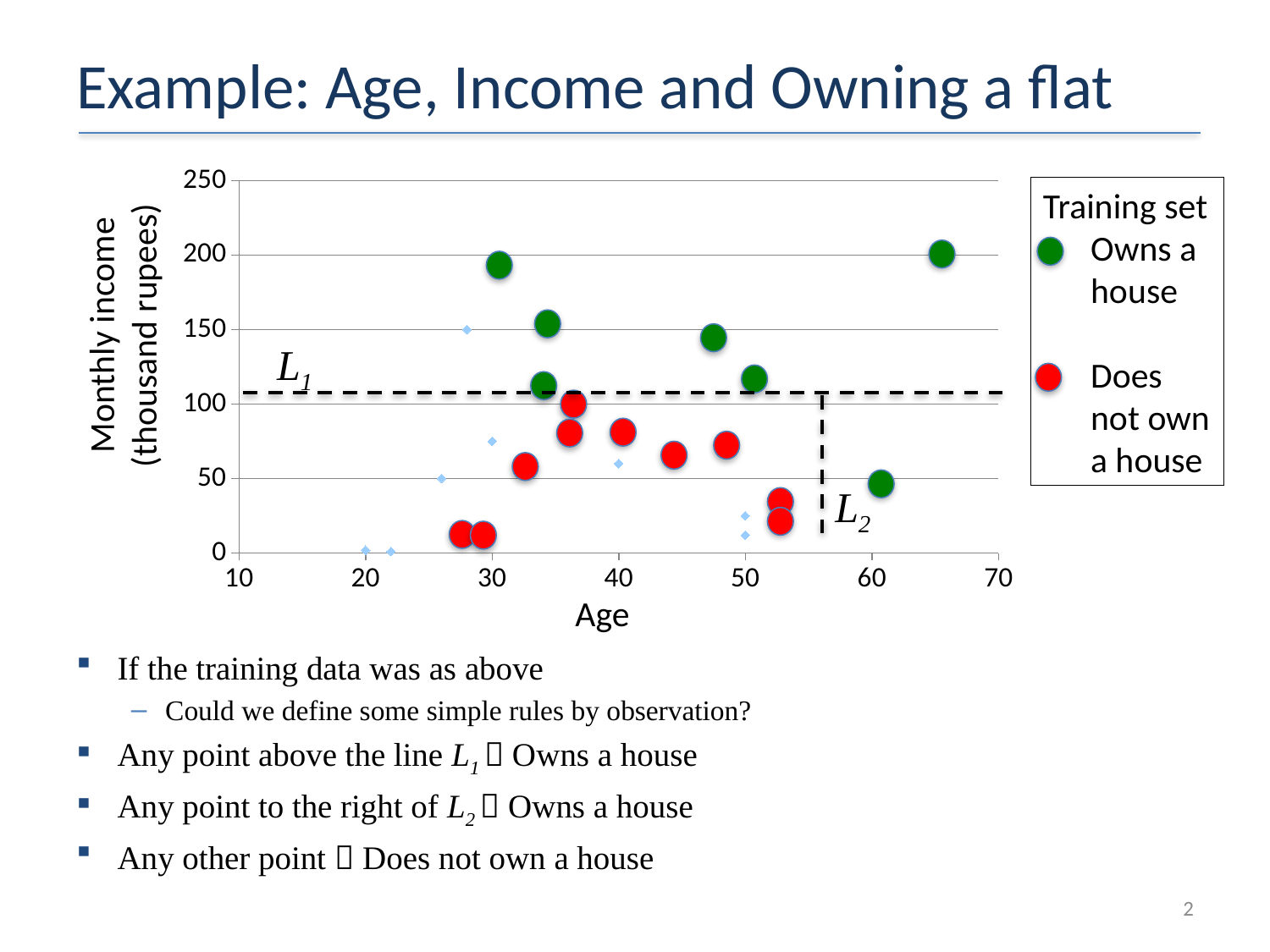
How many red 'Does not own a house' points are plotted on the chart? 10 Is the monthly income of the red point at about age 33 greater or less than 100? less What kind of chart is shown on the slide? Scatter chart Which colour marks the 'Does not own a house' points in the legend? Red Which group does the point with the highest age belong to, 'Owns a house' or 'Does not own a house'? Owns a house Is the monthly income of the green point at about age 65 greater or less than 150? greater Is the monthly income of the green point at about age 47 greater or less than 100? greater What is the maximum value shown on the y axis of the chart? 250 How many green 'Owns a house' points are plotted on the chart? 7 What is the title of the y axis of the chart? Monthly income (thousand rupees)